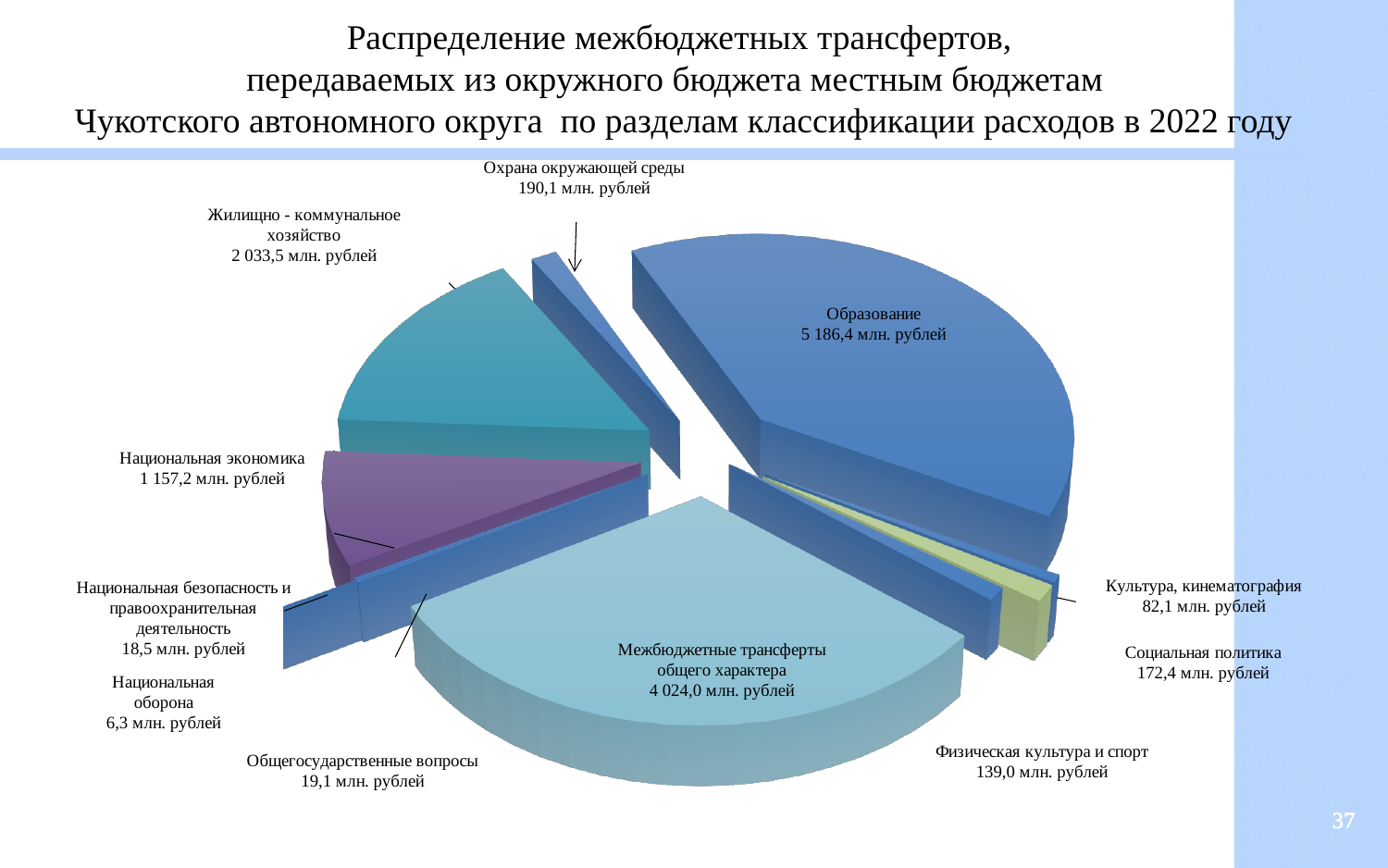
Which category has the smallest value? Национальная оборона What is the value for Образование? 5 186,4 млн. рублей What type of chart is shown on the slide? Pie chart What is the value for Физическая культура и спорт? 139,0 млн. рублей Which is larger: Социальная политика or Культура, кинематография? Социальная политика What is the value for Национальная экономика? 1 157,2 млн. рублей Which category has the largest value? Образование How many categories (slices) does the pie chart show? 11 What is the value for Межбюджетные трансферты общего характера? 4 024,0 млн. рублей Which is larger: Общегосударственные вопросы or Национальная безопасность и правоохранительная деятельность? Общегосударственные вопросы What is the difference between Жилищно-коммунальное хозяйство and Национальная экономика? 876,3 млн. рублей What is the difference between Образование and Межбюджетные трансферты общего характера? 1 162,4 млн. рублей